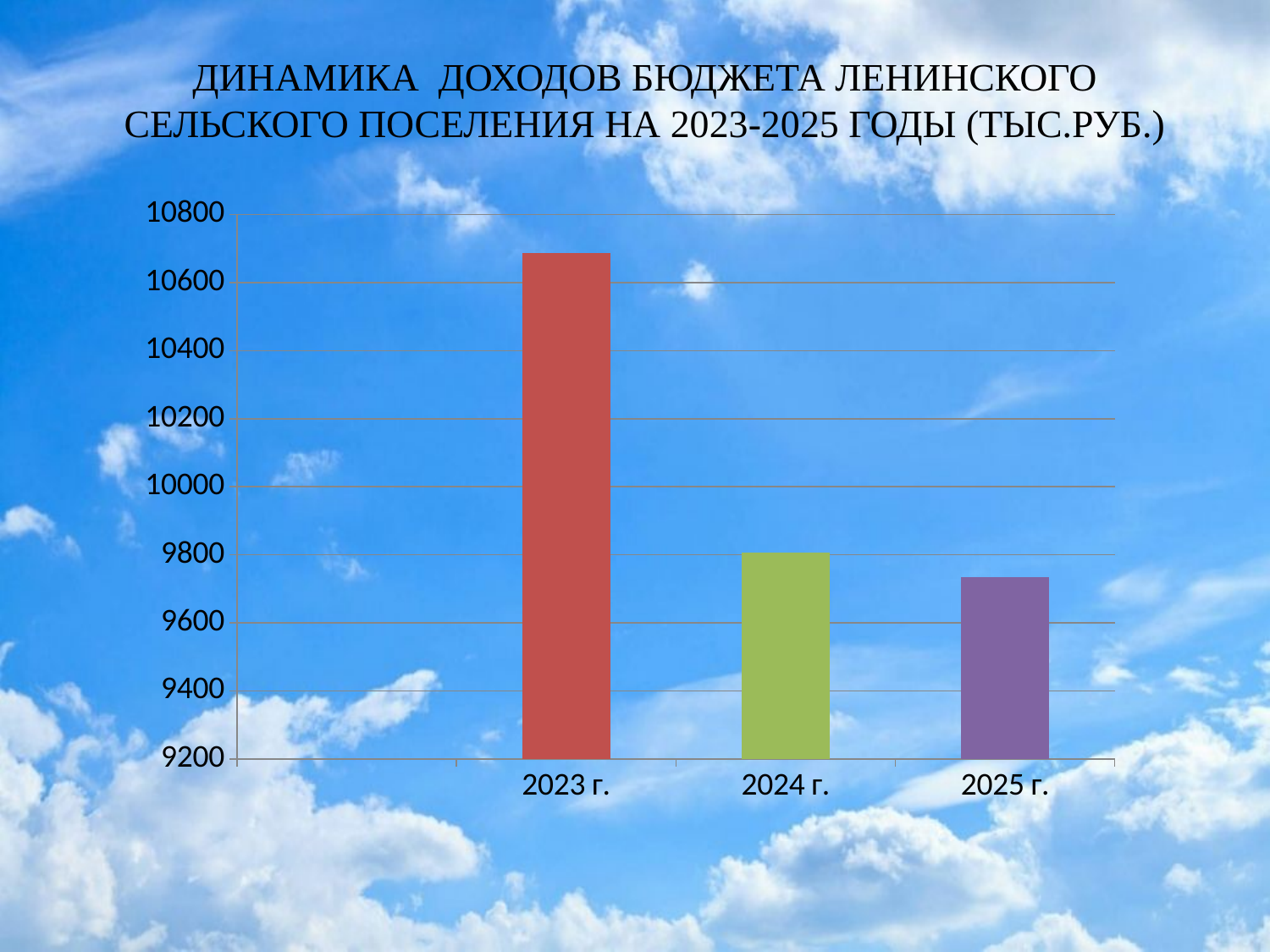
Which is larger, the value for 2024 г. or the value for 2025 г.? 2024 г. Is the value for 2023 г. greater or less than 10600? greater How many categories (years) are plotted on the chart? 3 Is the value for 2025 г. greater or less than 9800? less What is the lowest value shown on the vertical axis? 9200 Which year has the lowest budget income on the chart? 2025 г. Do the values rise or fall from 2023 г. to 2025 г.? fall What colour is the bar for 2023 г.? red What kind of chart is shown on the slide? bar chart Which year has the highest budget income on the chart? 2023 г. Which is larger, the value for 2023 г. or the value for 2024 г.? 2023 г. Is the value for 2024 г. greater or less than 10000? less